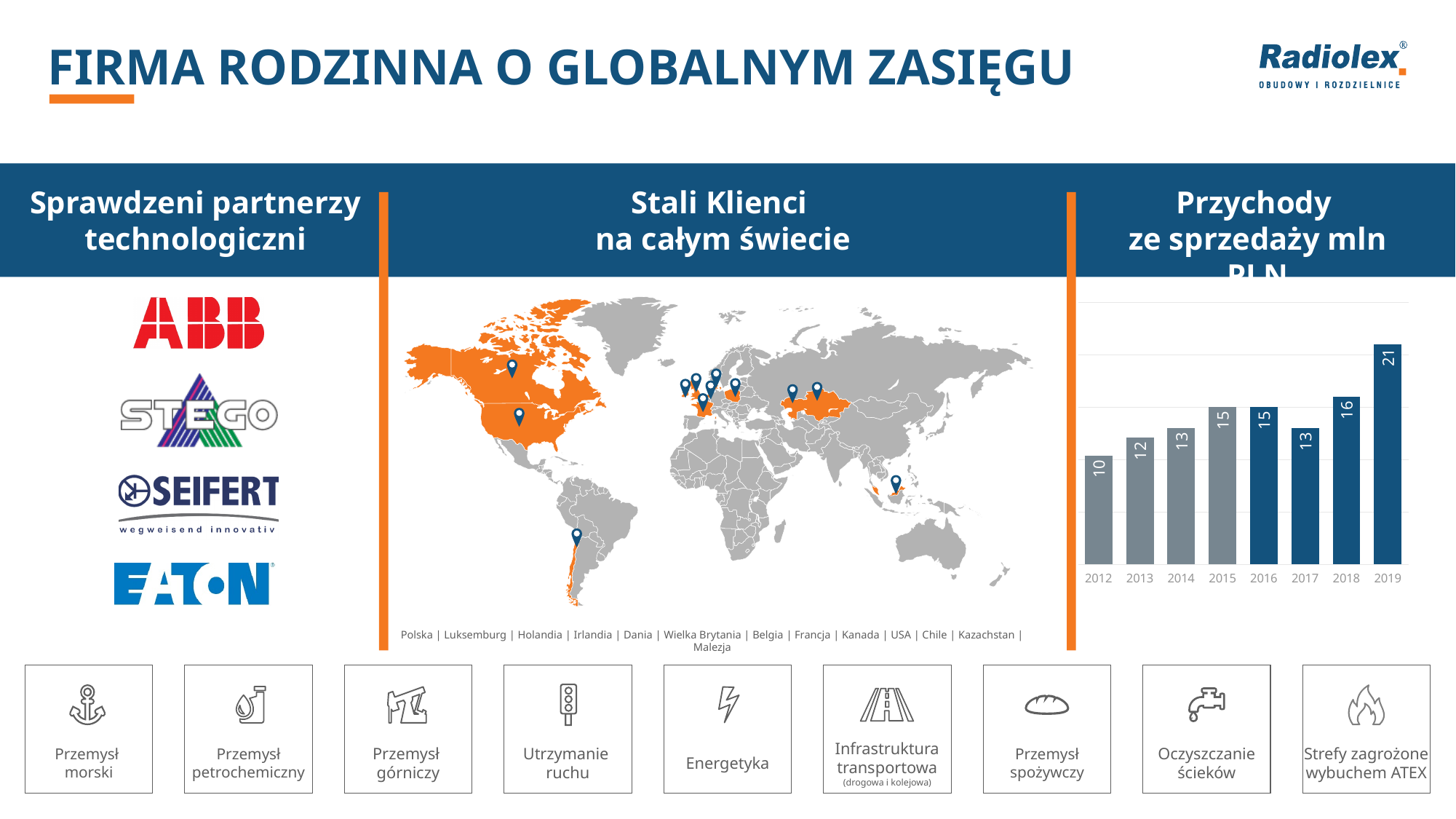
What unit is given in the title of the sales revenue chart? mln PLN Do the values in the sales revenue chart rise or fall from 2017 to 2019? rise Which is larger in the sales revenue chart, the value for 2016 or the value for 2017? 2016 Which year has the highest value in the sales revenue chart? 2019 What is the value for 2019 in the sales revenue chart? 21 What kind of chart is used to show sales revenue? bar chart What is the difference between the 2015 and 2012 values in the sales revenue chart? 5 How many years are shown on the x axis of the sales revenue chart? 8 What is the value for 2017 in the sales revenue chart? 13 What is the value for 2012 in the sales revenue chart? 10 What is the difference between the 2019 and 2018 values in the sales revenue chart? 5 Which year has the lowest value in the sales revenue chart? 2012